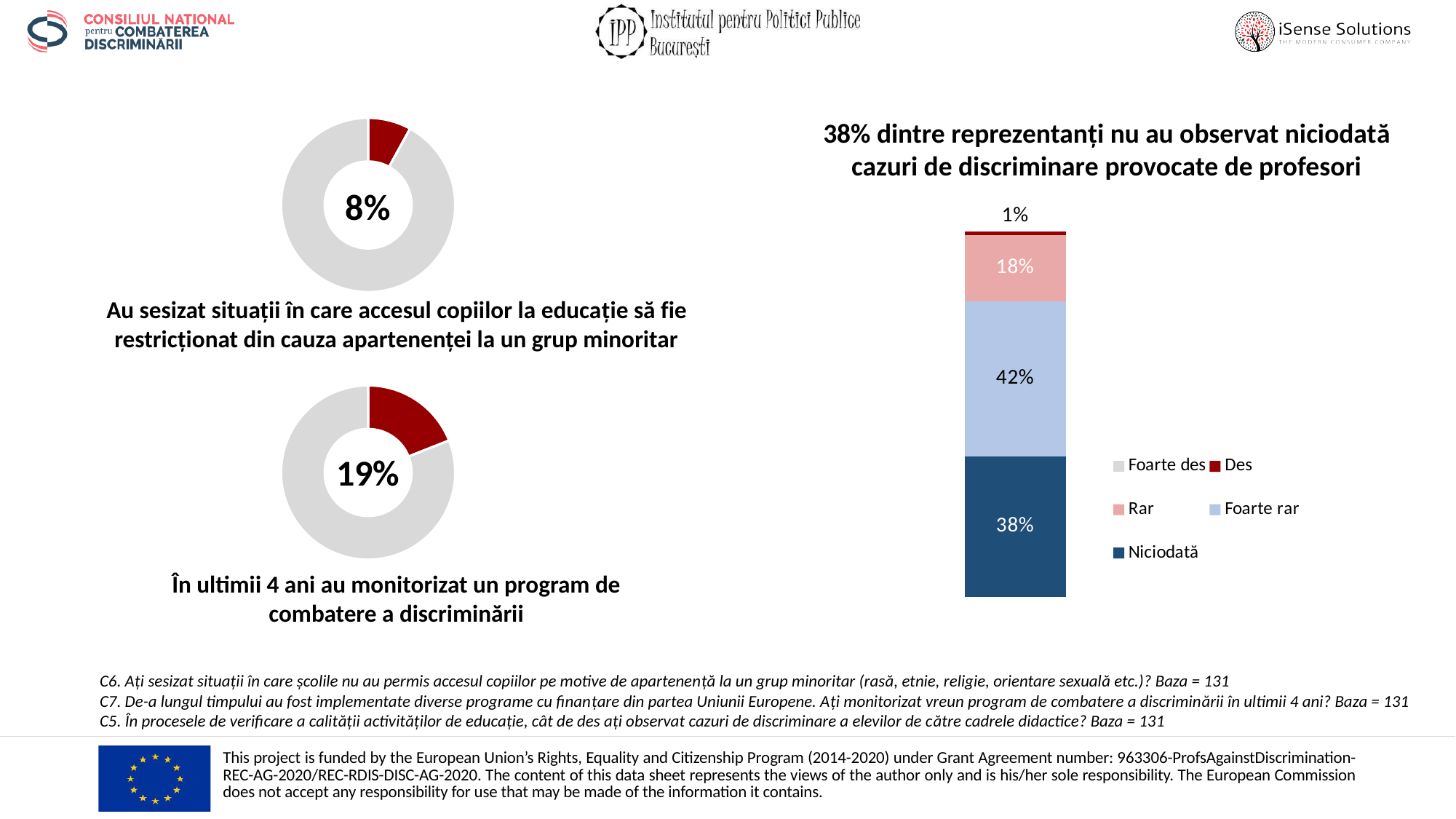
In the stacked bar chart on the right, which labelled category has the largest share? Foarte rar What is the difference between the percentages shown in the bottom-left donut chart (19%) and the top-left donut chart (8%)? 11% In the top-left donut chart, what percentage is shown for 'Au sesizat situații în care accesul copiilor la educație să fie restricționat din cauza apartenenței la un grup minoritar'? 8% In the stacked bar chart on the right, what percentage corresponds to 'Niciodată'? 38% In the stacked bar chart on the right, which is larger: 'Rar' or 'Niciodată'? Niciodată In the stacked bar chart on the right, what percentage corresponds to 'Rar'? 18% In the bottom-left donut chart, what percentage is shown for 'În ultimii 4 ani au monitorizat un program de combatere a discriminării'? 19% What kind of chart is shown on the right side of the slide? Stacked bar chart In the stacked bar chart on the right, what is the difference between the 'Foarte rar' and 'Niciodată' percentages? 4% How many entries does the legend of the stacked bar chart on the right list? 5 In the stacked bar chart on the right, what percentage corresponds to 'Foarte rar'? 42% In the stacked bar chart on the right, what percentage corresponds to 'Des'? 1%